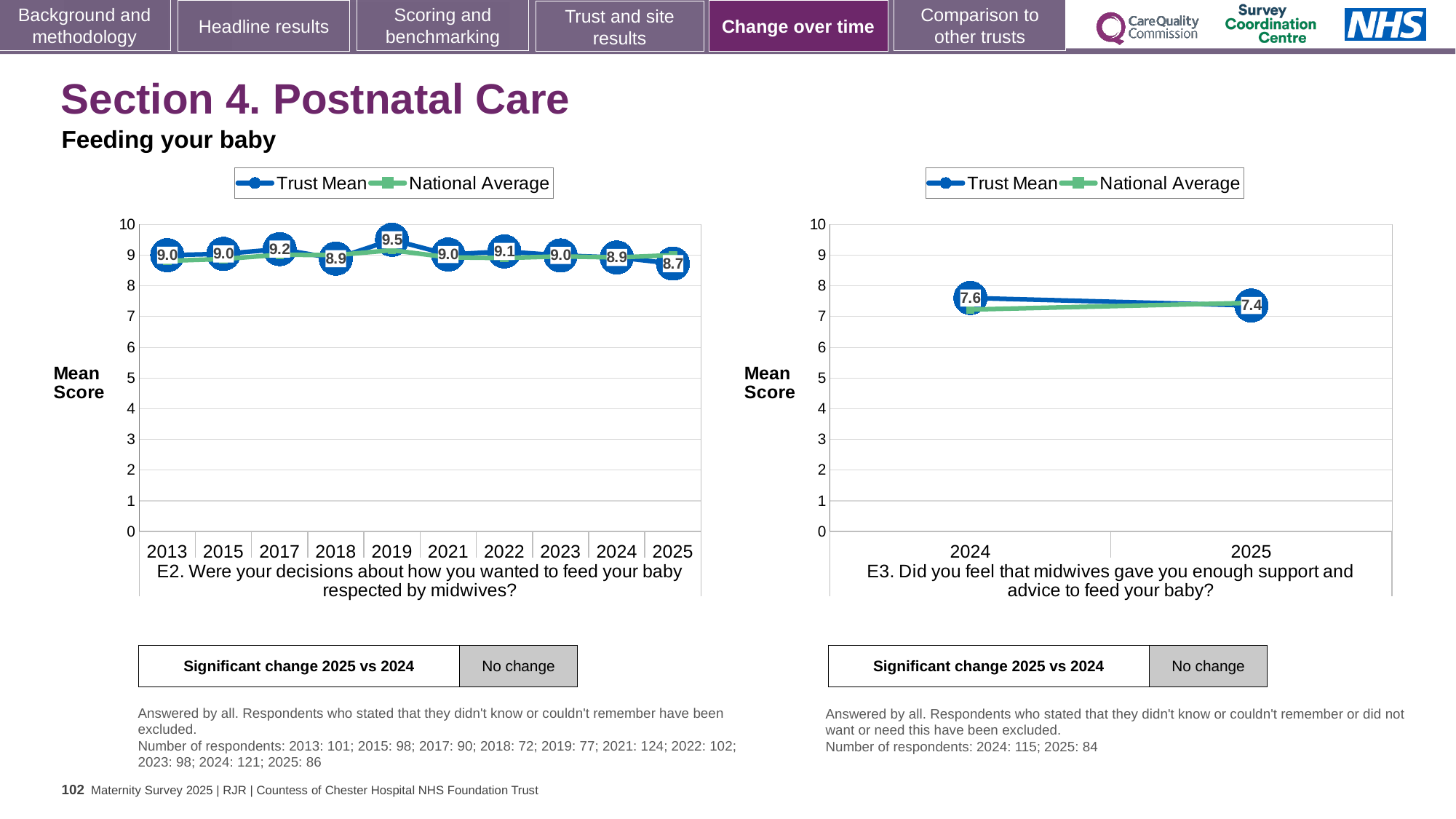
How many series does the legend of the E3 chart (right) list? 2 In the E2 chart (left), what is the Trust Mean for 2019? 9.5 In the E2 chart (left), what is the Trust Mean for 2025? 8.7 In the E2 chart (left), what is the difference between the Trust Mean for 2019 and the Trust Mean for 2025? 0.8 In the E3 chart (right), what is the Trust Mean for 2024? 7.6 In the E2 chart (left), which year has the highest Trust Mean? 2019 What kind of chart is the E2 chart (left)? line chart In the E2 chart (left), how many years are plotted on the x axis? 10 In the E3 chart (right), is the Trust Mean for 2024 greater or less than 8? less In the E3 chart (right), what is the Trust Mean for 2025? 7.4 In the E3 chart (right), does the Trust Mean rise or fall from 2024 to 2025? fall In the E2 chart (left), which year has the lowest Trust Mean? 2025